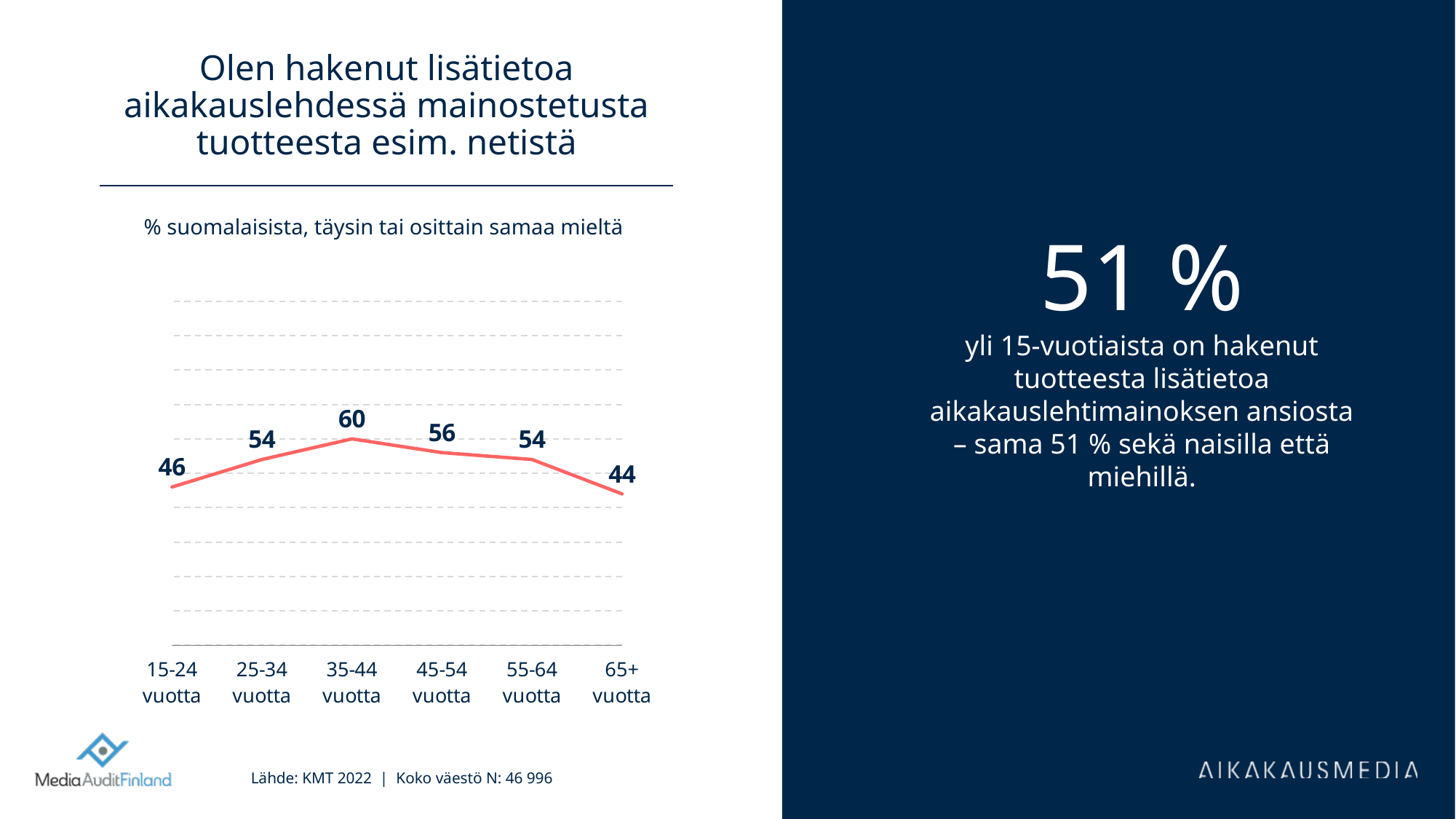
What kind of chart is shown on the slide? Line chart What is the difference between the values for 35-44 vuotta and 65+ vuotta? 16 Do the values rise or fall from 35-44 vuotta to 65+ vuotta? Fall What is the value for the 65+ vuotta age group? 44 What is the value for the 15-24 vuotta age group? 46 Which is larger, the value for 25-34 vuotta or the value for 45-54 vuotta? 45-54 vuotta What is the value for the 35-44 vuotta age group? 60 Which age group has the lowest value? 65+ vuotta How many age groups are plotted on the chart? 6 Which age group has the highest value? 35-44 vuotta What is the value for the 45-54 vuotta age group? 56 What is the title of the chart? Olen hakenut lisätietoa aikakauslehdessä mainostetusta tuotteesta esim. netistä